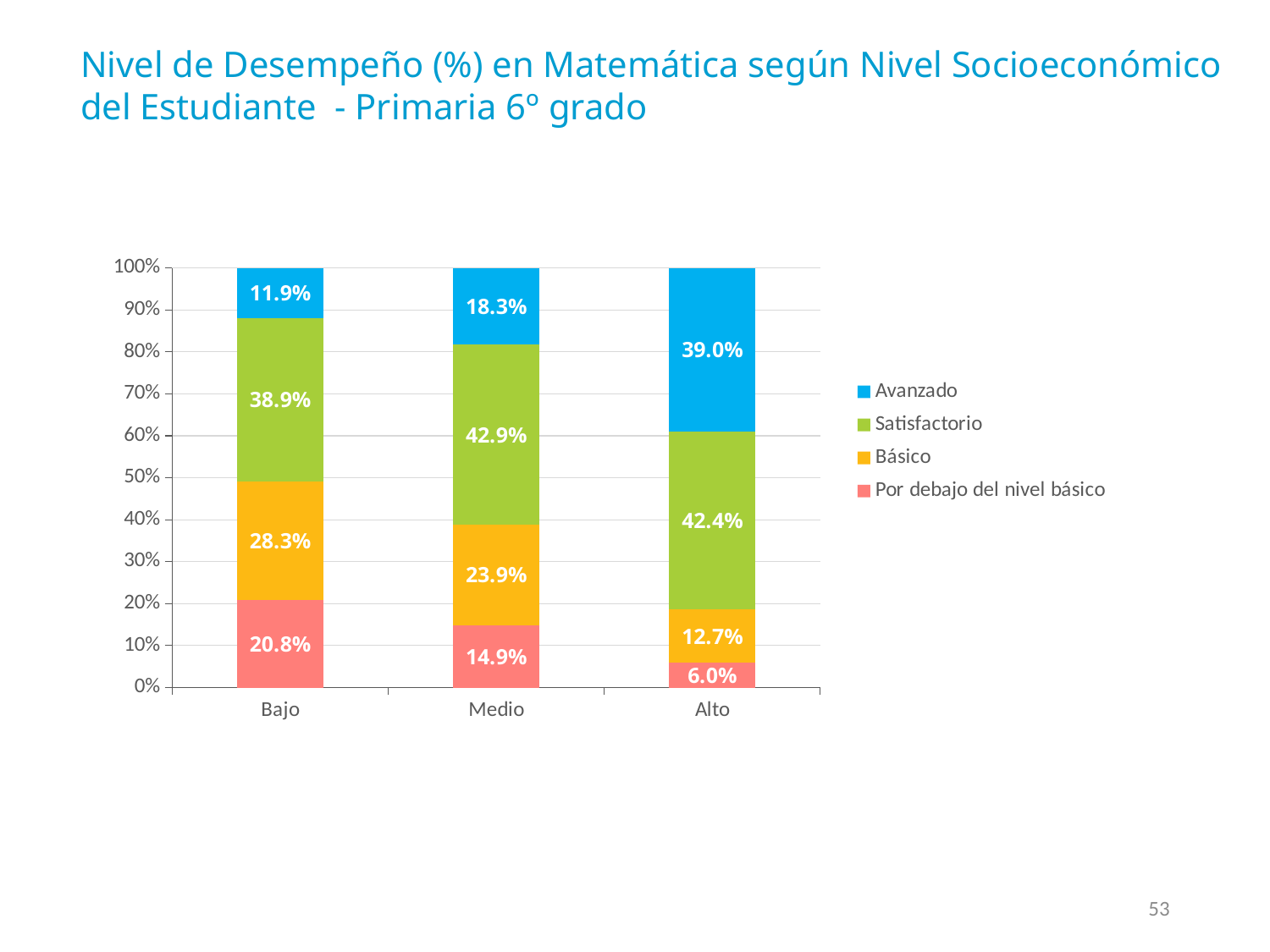
What is the Por debajo del nivel básico value for the Bajo category? 20.8% Which colour represents the Básico series? Yellow What is the Avanzado value for the Alto category? 39.0% Which is larger, the Satisfactorio value for Medio or for Alto? Medio What is the Básico value for the Medio category? 23.9% How many categories are shown on the x axis? 3 What kind of chart is shown on the slide? Stacked bar chart Which category has the lowest Por debajo del nivel básico value? Alto Which category has the highest Avanzado value? Alto How many series does the legend list? 4 Do the Avanzado values rise or fall from Bajo to Alto? Rise What is the difference between the Avanzado values for Alto and Bajo? 27.1%